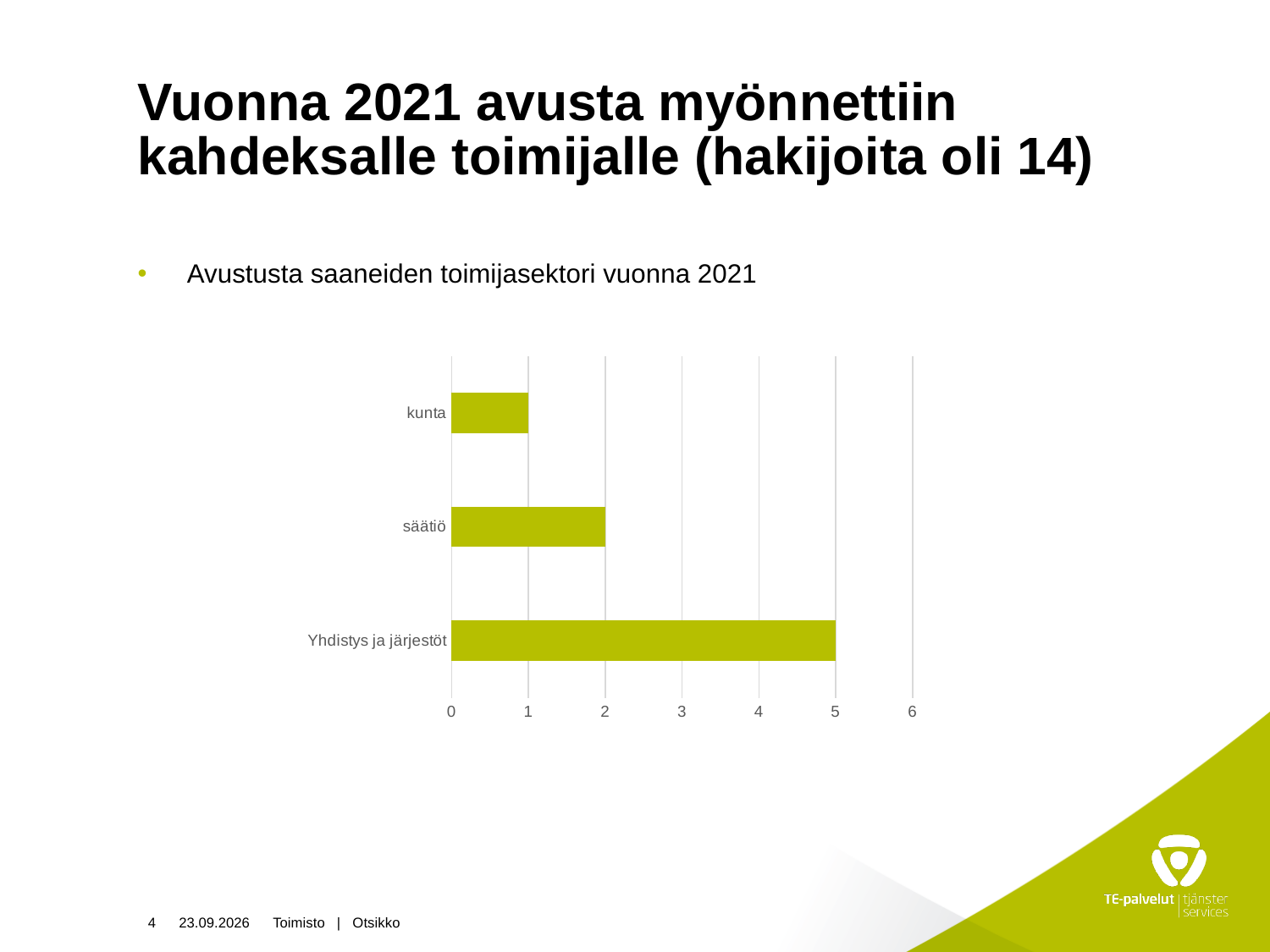
Which is larger, the value for säätiö or the value for kunta? säätiö Which category has the lowest value? kunta What is the difference between the values for Yhdistys ja järjestöt and säätiö? 3 How many categories are shown in the chart? 3 What is the value for kunta? 1 What is the highest value shown on the x axis? 6 What is the value for säätiö? 2 What kind of chart is shown on the slide? bar chart Is the value for Yhdistys ja järjestöt greater or less than 4? greater What is the value for Yhdistys ja järjestöt? 5 What is the difference between the values for säätiö and kunta? 1 Which category has the highest value? Yhdistys ja järjestöt